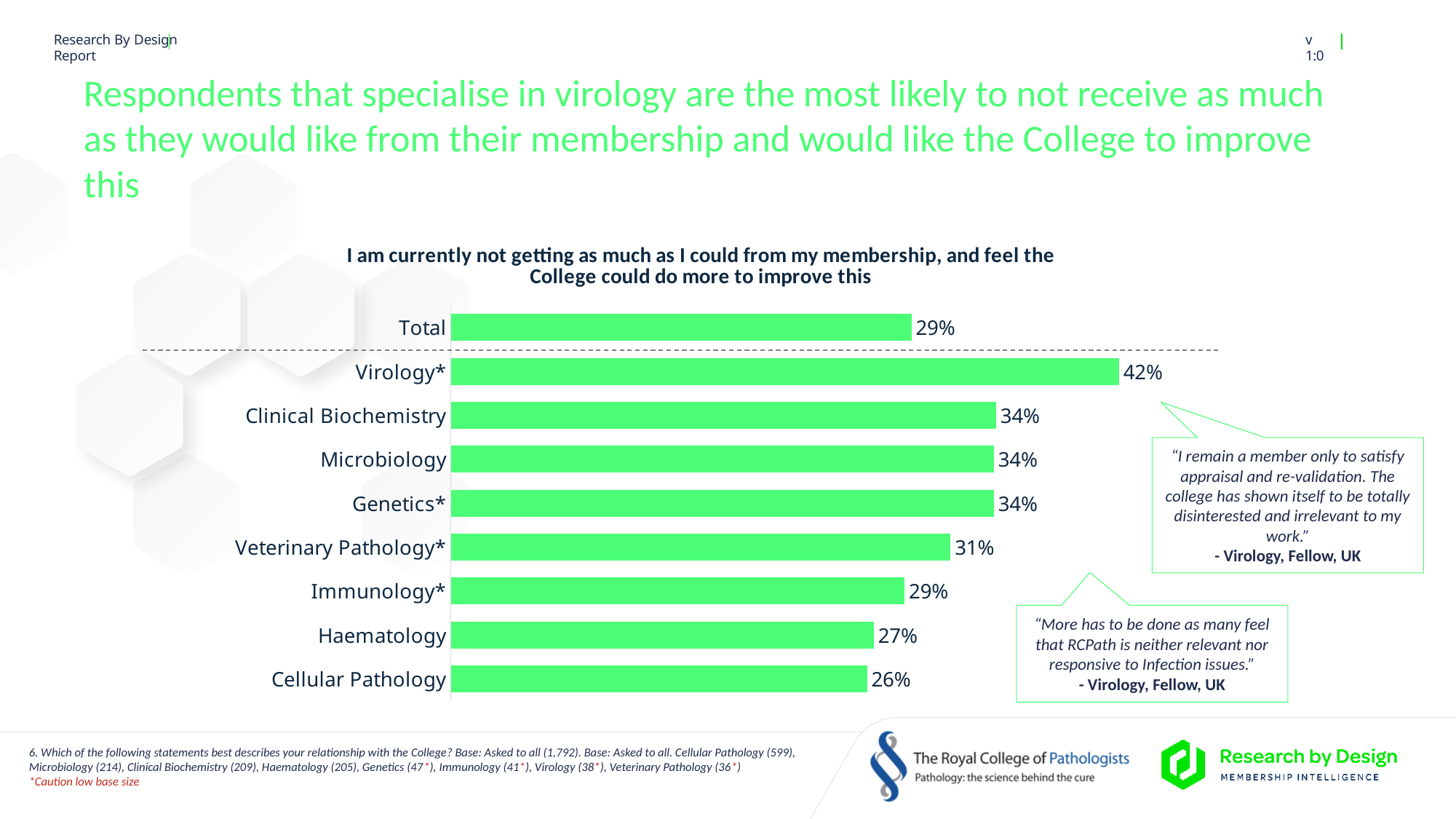
What is the value for Total? 29% Which is larger, the value for Immunology* or the value for Haematology? Immunology* What kind of chart is shown on the slide? Bar chart Which category has the highest value? Virology* What is the value for Virology*? 42% Which category has the lowest value? Cellular Pathology What is the value for Haematology? 27% How many categories are shown in the chart, including Total? 9 What is the difference between the values for Clinical Biochemistry and Total? 5% What is the title of the chart? I am currently not getting as much as I could from my membership, and feel the College could do more to improve this What is the value for Veterinary Pathology*? 31% What is the difference between the values for Virology* and Cellular Pathology? 16%